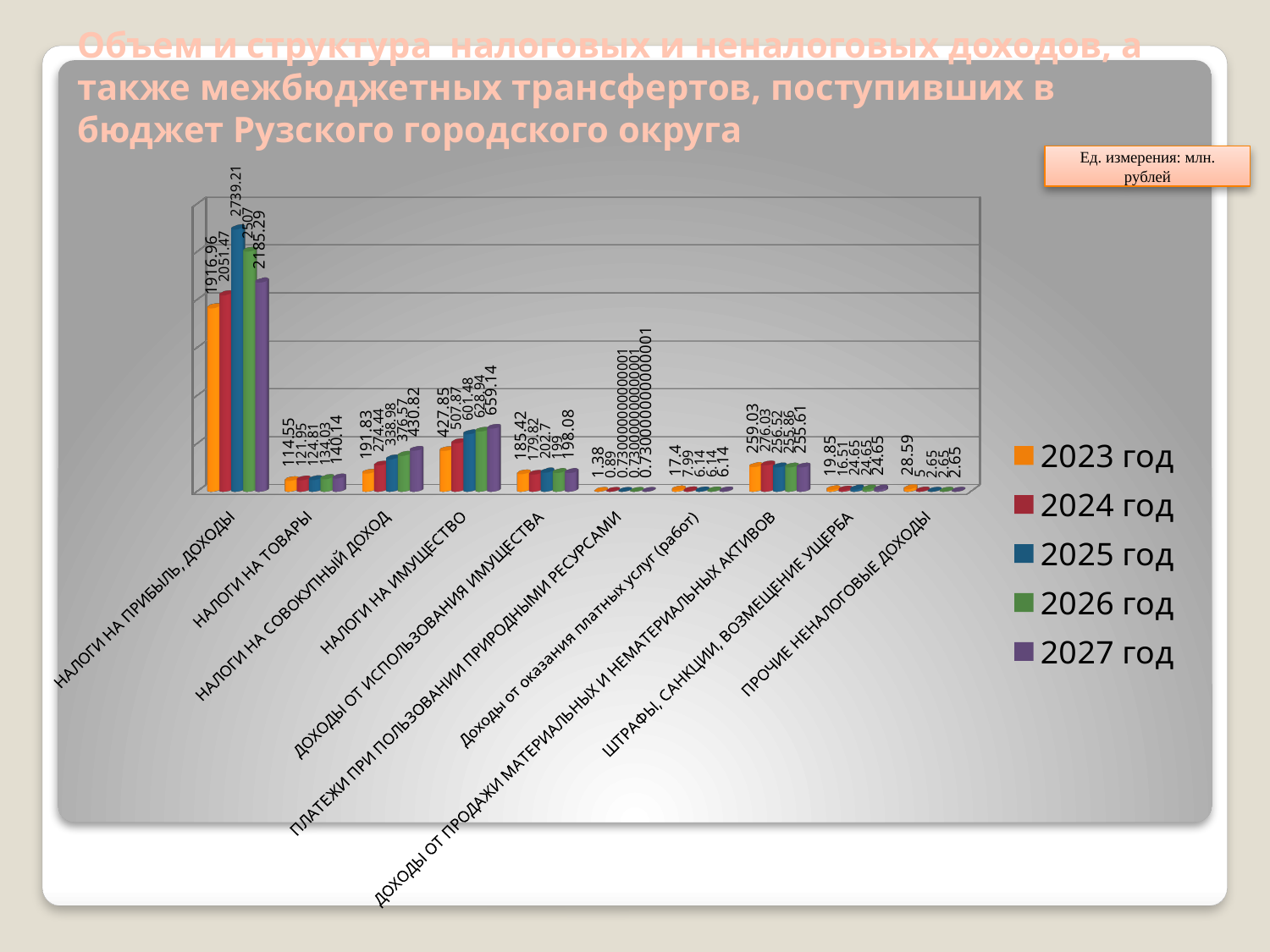
What unit of measurement is stated on the slide for the chart values? млн. рублей What is the difference between the 2027 год and 2023 год values for НАЛОГИ НА СОВОКУПНЫЙ ДОХОД? 238.99 Do the values for НАЛОГИ НА ИМУЩЕСТВО rise or fall from 2023 год to 2027 год? rise What is the value for ПРОЧИЕ НЕНАЛОГОВЫЕ ДОХОДЫ in 2023 год? 28.59 How many series does the legend list? 5 What is the value for НАЛОГИ НА ИМУЩЕСТВО in 2023 год? 427.85 Which category has the highest value in 2025 год? НАЛОГИ НА ПРИБЫЛЬ, ДОХОДЫ How many categories are shown on the x axis of the chart? 10 Which year has the lowest value for Доходы от оказания платных услуг (работ) among 2023 год and 2024 год? 2024 год What is the value for НАЛОГИ НА ТОВАРЫ in 2027 год? 140.14 What type of chart is shown on the slide? bar chart What is the value for НАЛОГИ НА СОВОКУПНЫЙ ДОХОД in 2025 год? 338.98